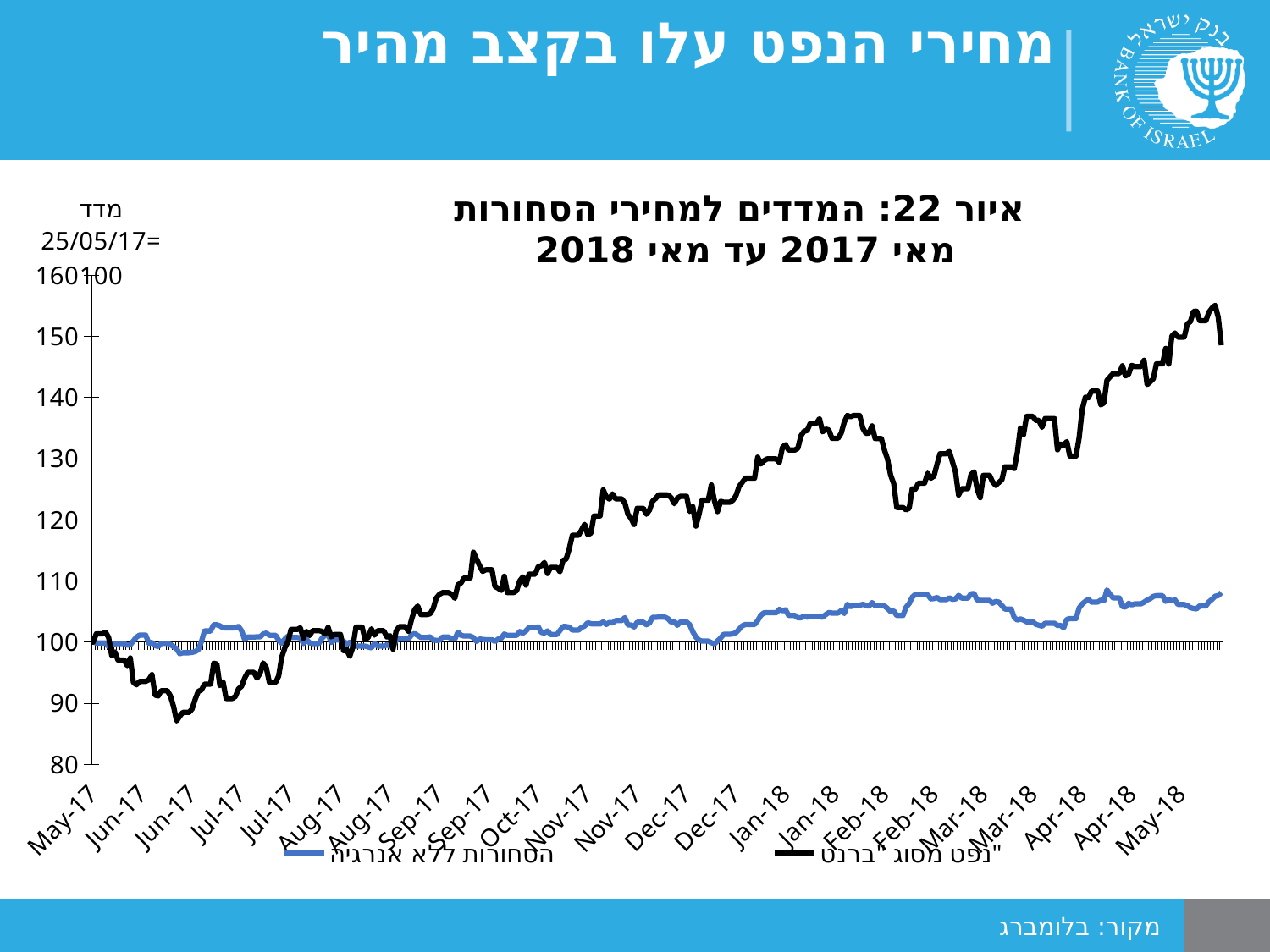
Is the value of the Brent oil (נפט מסוג ברנט) series in Jan-18 greater or less than 130? greater How many series does the legend list? 2 At May-18, which series has the higher value: Brent oil (נפט מסוג ברנט) or commodities excluding energy (הסחורות ללא אנרגיה)? נפט מסוג ברנט Is the value of the commodities excluding energy (הסחורות ללא אנרגיה) series at the end of the chart (May-18) greater or less than 110? less What is the base value of the index, and on what date is it set? 25/05/17=100 Which series reaches the highest value on the chart? נפט מסוג ברנט What kind of chart is shown on the slide? line chart Which series is drawn in black? נפט מסוג ברנט Is the value of the Brent oil (נפט מסוג ברנט) series at the end of the chart (May-18) greater or less than 140? greater Does the Brent oil (נפט מסוג ברנט) series rise or fall overall from May-17 to May-18? rise What is the title of the chart? איור 22: המדדים למחירי הסחורות מאי 2017 עד מאי 2018